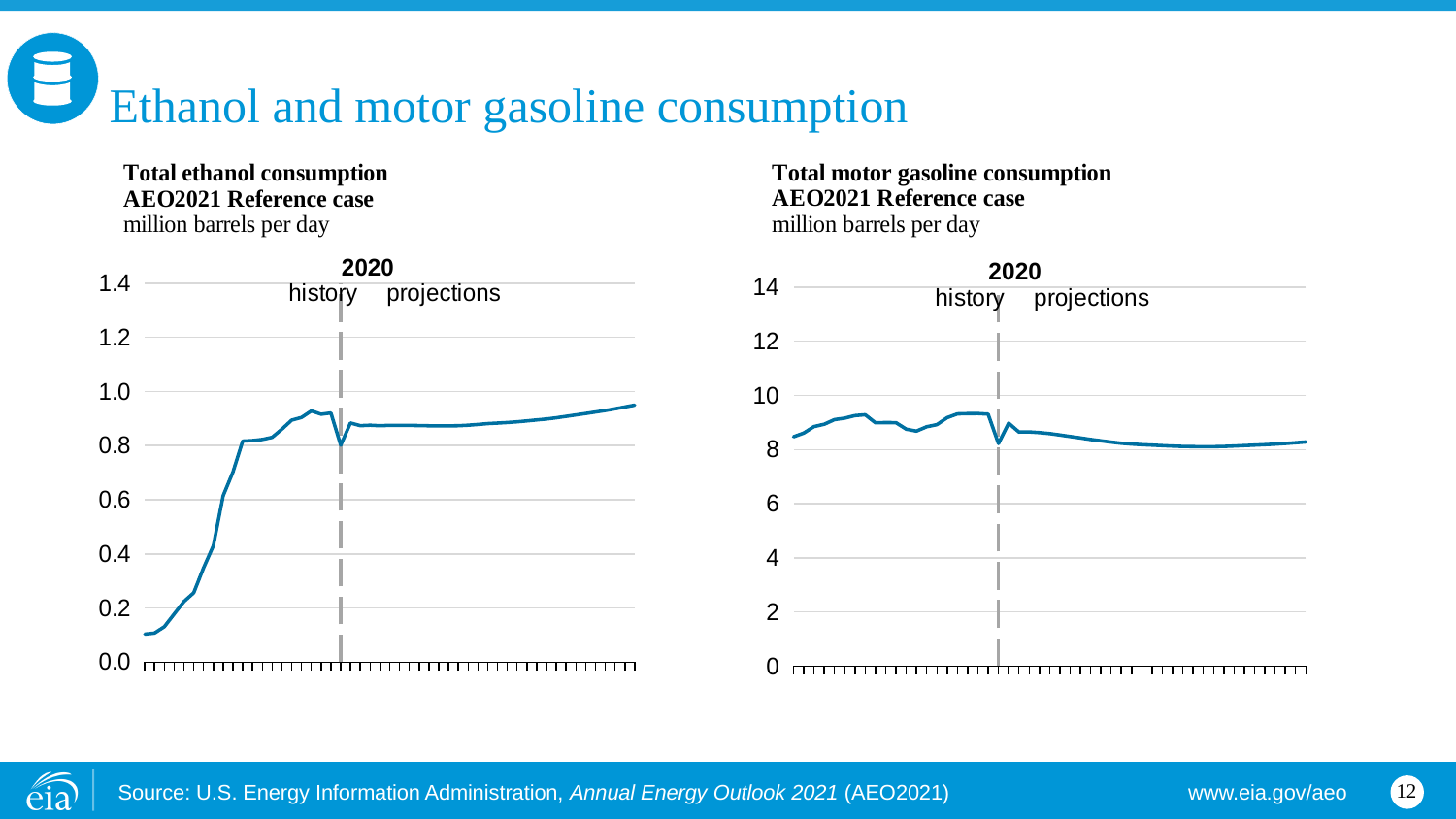
What unit is used on the y axis of both charts? million barrels per day In the 'Total ethanol consumption' chart, is the value at the 2020 dashed line greater or less than 1.0? less In the 'Total motor gasoline consumption' chart, is the value at the end of the projection period greater or less than 10? less In the 'Total ethanol consumption' chart, is the value at the start of the history period greater or less than 0.2? less In the 'Total ethanol consumption' chart, does the line generally rise or fall over the projection period after 2020? rise What kind of chart is the 'Total ethanol consumption' chart on the left? line chart In the 'Total motor gasoline consumption' chart, does the line generally rise or fall over the projection period after 2020? fall What year does the vertical dashed line separating history from projections mark in both charts? 2020 How many charts are shown on the slide? 2 What kind of chart is the 'Total motor gasoline consumption' chart on the right? line chart